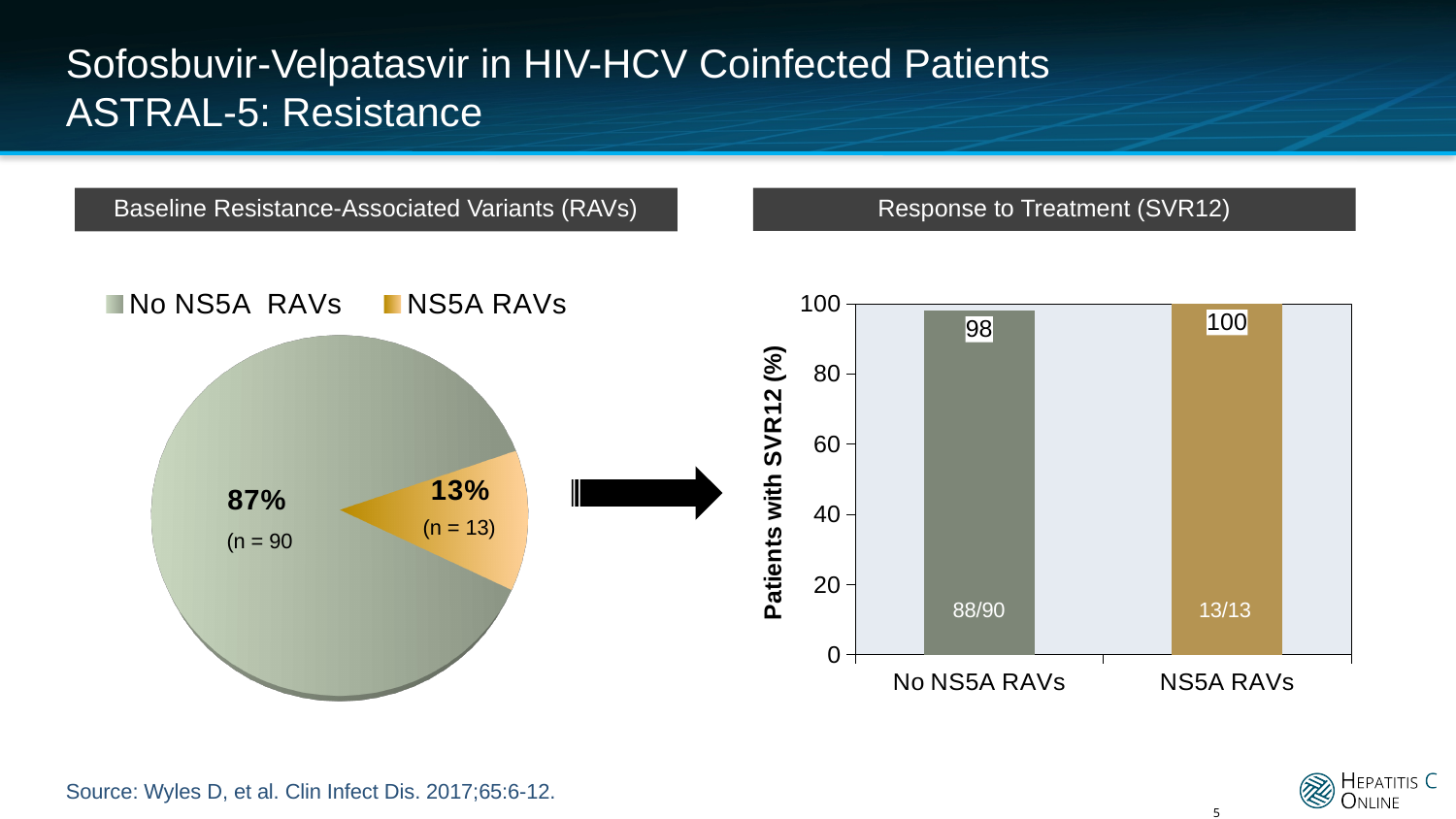
In the Baseline Resistance-Associated Variants (RAVs) pie chart, how many slices are there? 2 In the Response to Treatment (SVR12) chart, what is the SVR12 rate for patients with No NS5A RAVs? 98 In the Baseline Resistance-Associated Variants (RAVs) chart, what kind of chart is shown? pie chart In the Response to Treatment (SVR12) chart, what is the y-axis label? Patients with SVR12 (%) In the Baseline Resistance-Associated Variants (RAVs) pie chart, what share of patients had NS5A RAVs? 13% In the Response to Treatment (SVR12) chart, what is the difference between the SVR12 rates for NS5A RAVs and No NS5A RAVs? 2 In the Baseline Resistance-Associated Variants (RAVs) pie chart, which slice is larger, No NS5A RAVs or NS5A RAVs? No NS5A RAVs In the Response to Treatment (SVR12) chart, what fraction is printed inside the No NS5A RAVs bar? 88/90 In the Baseline Resistance-Associated Variants (RAVs) pie chart, how many patients are in the NS5A RAVs slice? n = 13 In the Response to Treatment (SVR12) chart, what kind of chart is shown? bar chart In the Response to Treatment (SVR12) chart, what is the SVR12 rate for patients with NS5A RAVs? 100 In the Baseline Resistance-Associated Variants (RAVs) pie chart, what share of patients had No NS5A RAVs? 87%